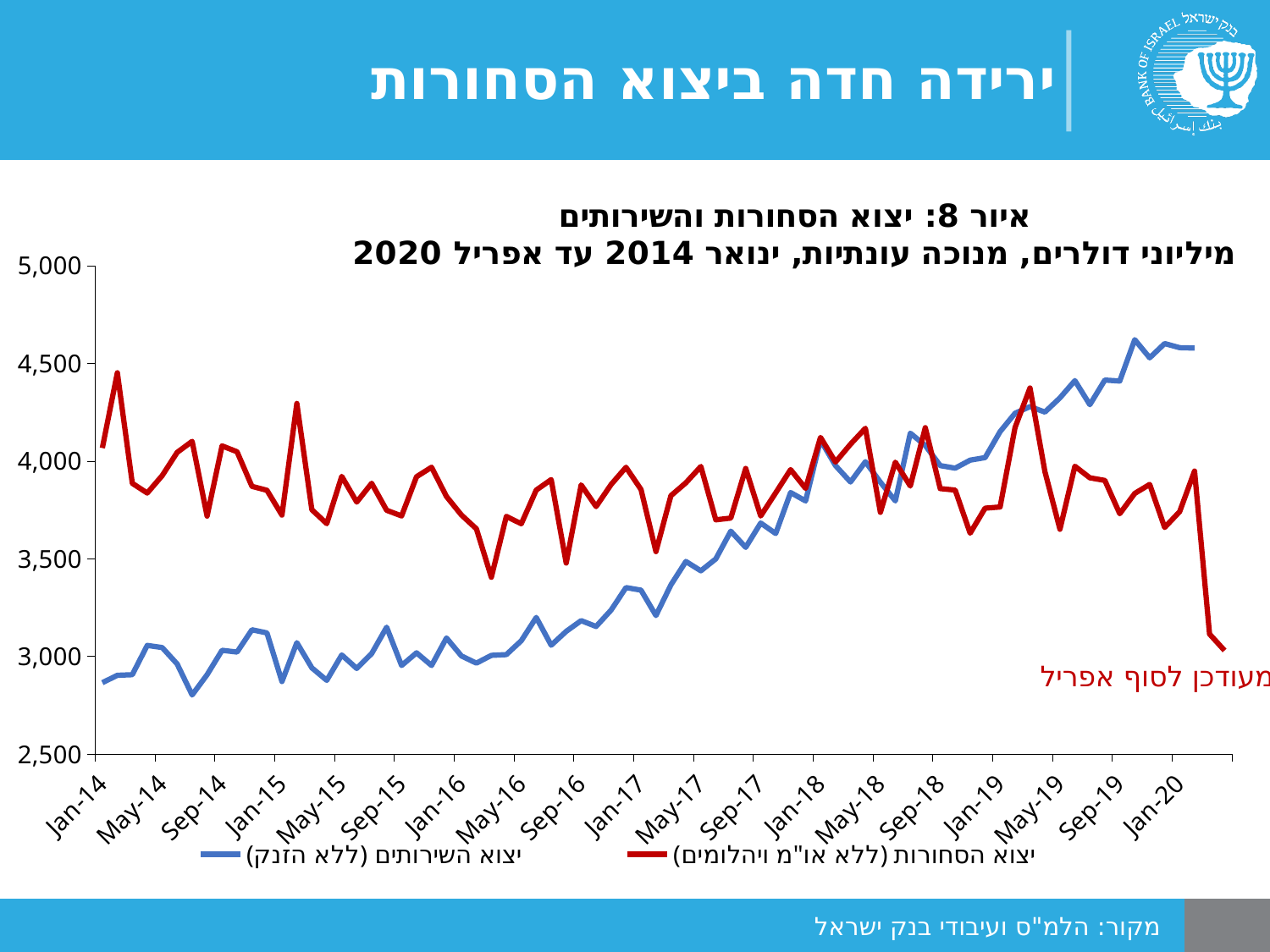
What is the figure number given in the chart title? איור 8 Is the value of the blue services exports line (יצוא השירותים) at Jan-14 greater or less than 3,000? less Is the value of the blue services exports line at Jan-20 greater or less than 4,500? greater Is the value of the blue services exports line at Jan-17 greater or less than 3,500? less Does the red goods exports line rise or fall sharply at the very end of the series (early 2020)? fall At Jan-14, which series has the higher value: goods exports (red) or services exports (blue)? goods exports (red) How many series does the legend list? 2 Does the blue services exports line generally rise or fall from Jan-14 to Jan-20? rise At Jan-20, which series has the higher value: goods exports (red) or services exports (blue)? services exports (blue) What kind of chart is shown on the slide? line chart